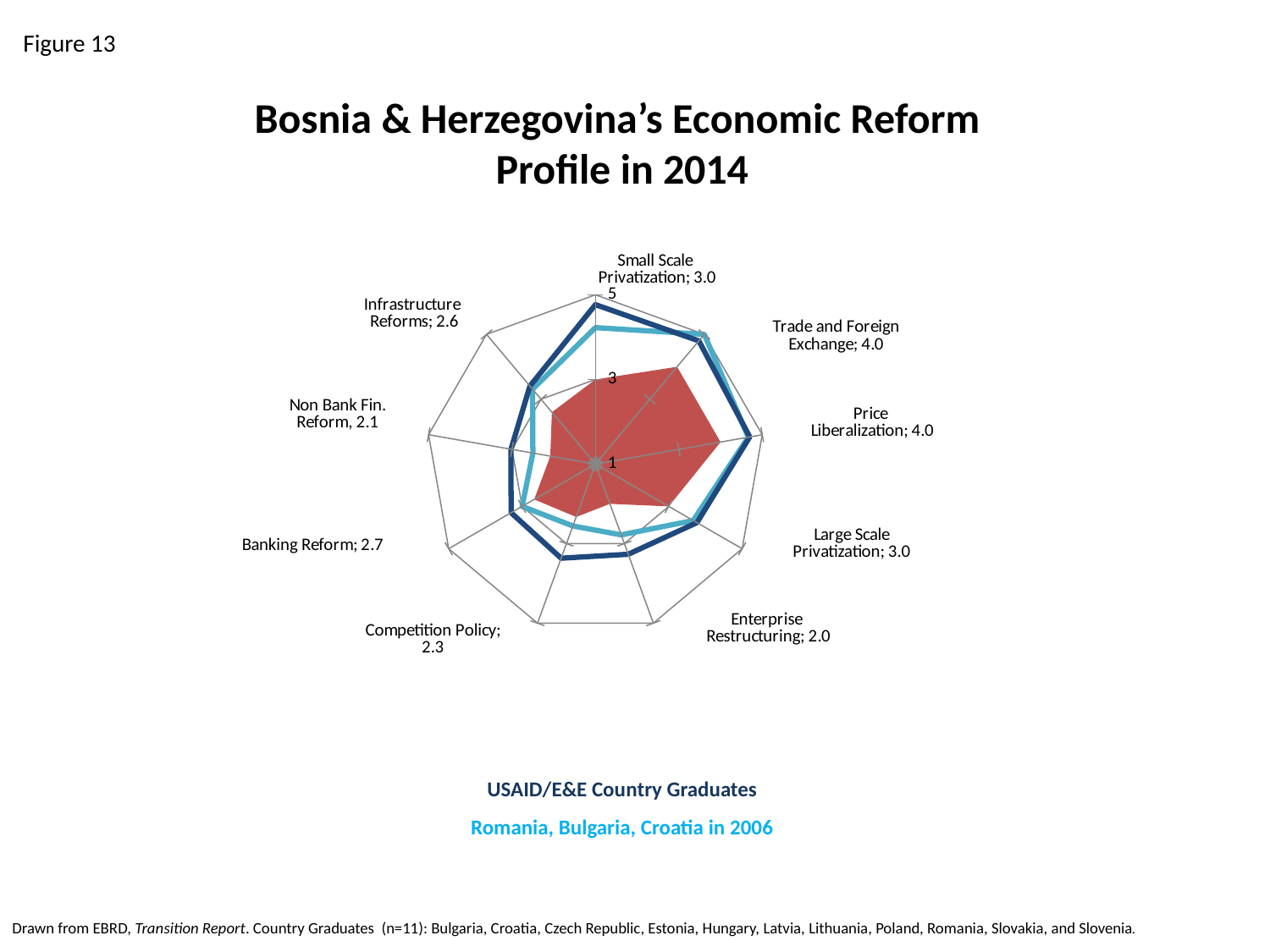
What is Bosnia & Herzegovina's value for Banking Reform? 2.7 Which category has the lowest value for Bosnia & Herzegovina? Enterprise Restructuring What is the difference between Bosnia & Herzegovina's Price Liberalization and Enterprise Restructuring values? 2.0 How many reform categories are plotted on the chart? 9 What is Bosnia & Herzegovina's value for Enterprise Restructuring? 2.0 What kind of chart is shown on the slide? Radar chart Which is larger for Bosnia & Herzegovina: Banking Reform or Competition Policy? Banking Reform What is the title of the chart? Bosnia & Herzegovina's Economic Reform Profile in 2014 Which comparison group is shown in light blue in the legend? Romania, Bulgaria, Croatia in 2006 Is the USAID/E&E Country Graduates value for Small Scale Privatization greater or less than 3? greater What is Bosnia & Herzegovina's value for Trade and Foreign Exchange? 4.0 What is Bosnia & Herzegovina's value for Non Bank Fin. Reform? 2.1